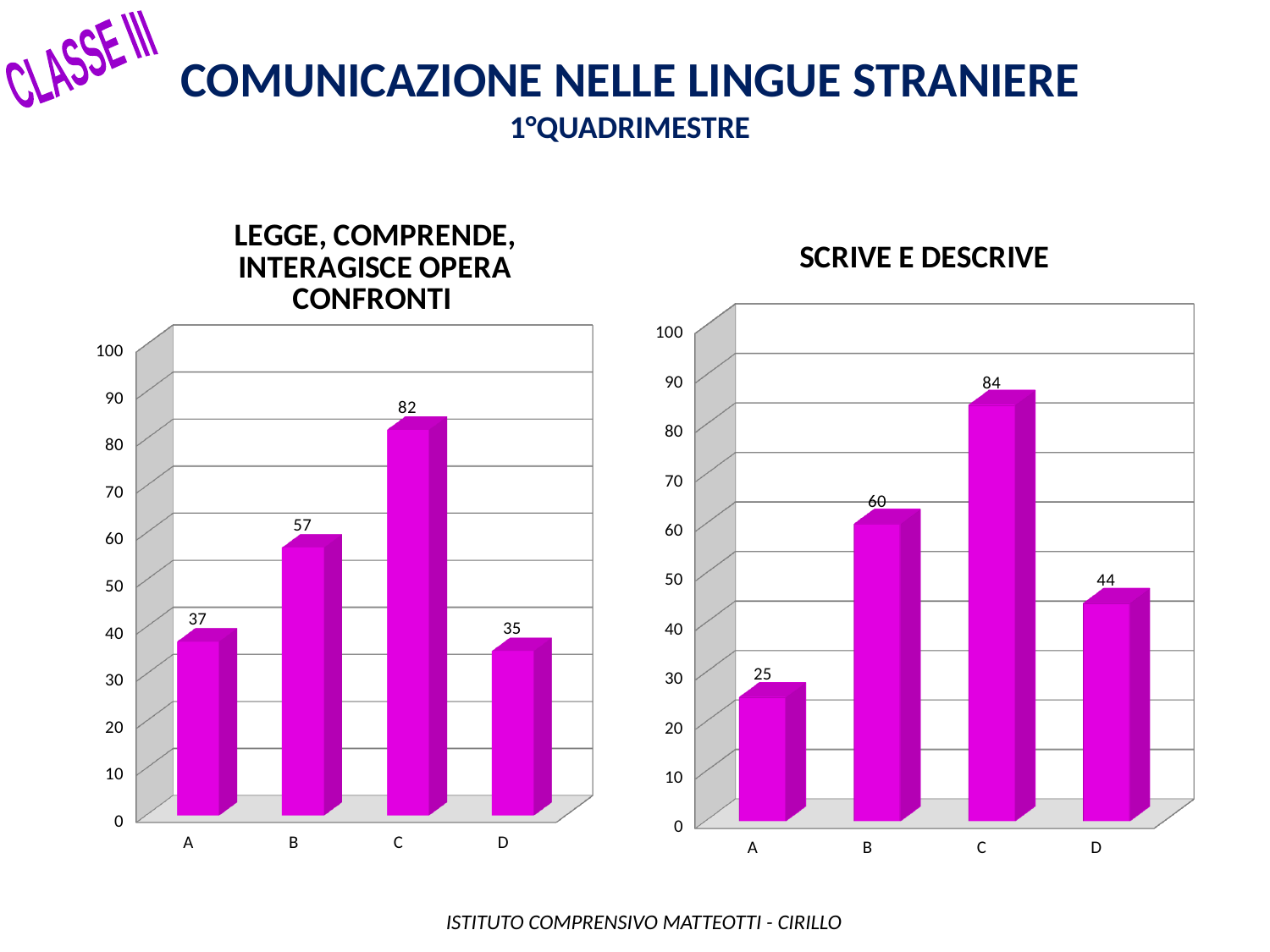
In the 'SCRIVE E DESCRIVE' chart, is the value for D greater or less than 50? less In the 'SCRIVE E DESCRIVE' chart, what is the value for category A? 25 What is the title of the chart on the right side of the slide? SCRIVE E DESCRIVE In the 'LEGGE, COMPRENDE, INTERAGISCE OPERA CONFRONTI' chart, what is the value for category B? 57 How many categories are shown in the 'SCRIVE E DESCRIVE' chart? 4 In the 'LEGGE, COMPRENDE, INTERAGISCE OPERA CONFRONTI' chart, which is larger, the value for A or the value for D? A In the 'LEGGE, COMPRENDE, INTERAGISCE OPERA CONFRONTI' chart, which category has the highest value? C In the 'LEGGE, COMPRENDE, INTERAGISCE OPERA CONFRONTI' chart, what is the value for category C? 82 In the 'SCRIVE E DESCRIVE' chart, what is the difference between the values for C and B? 24 In the 'LEGGE, COMPRENDE, INTERAGISCE OPERA CONFRONTI' chart, what is the difference between the values for B and D? 22 In the 'SCRIVE E DESCRIVE' chart, which category has the lowest value? A What kind of chart is the 'LEGGE, COMPRENDE, INTERAGISCE OPERA CONFRONTI' chart? Bar chart